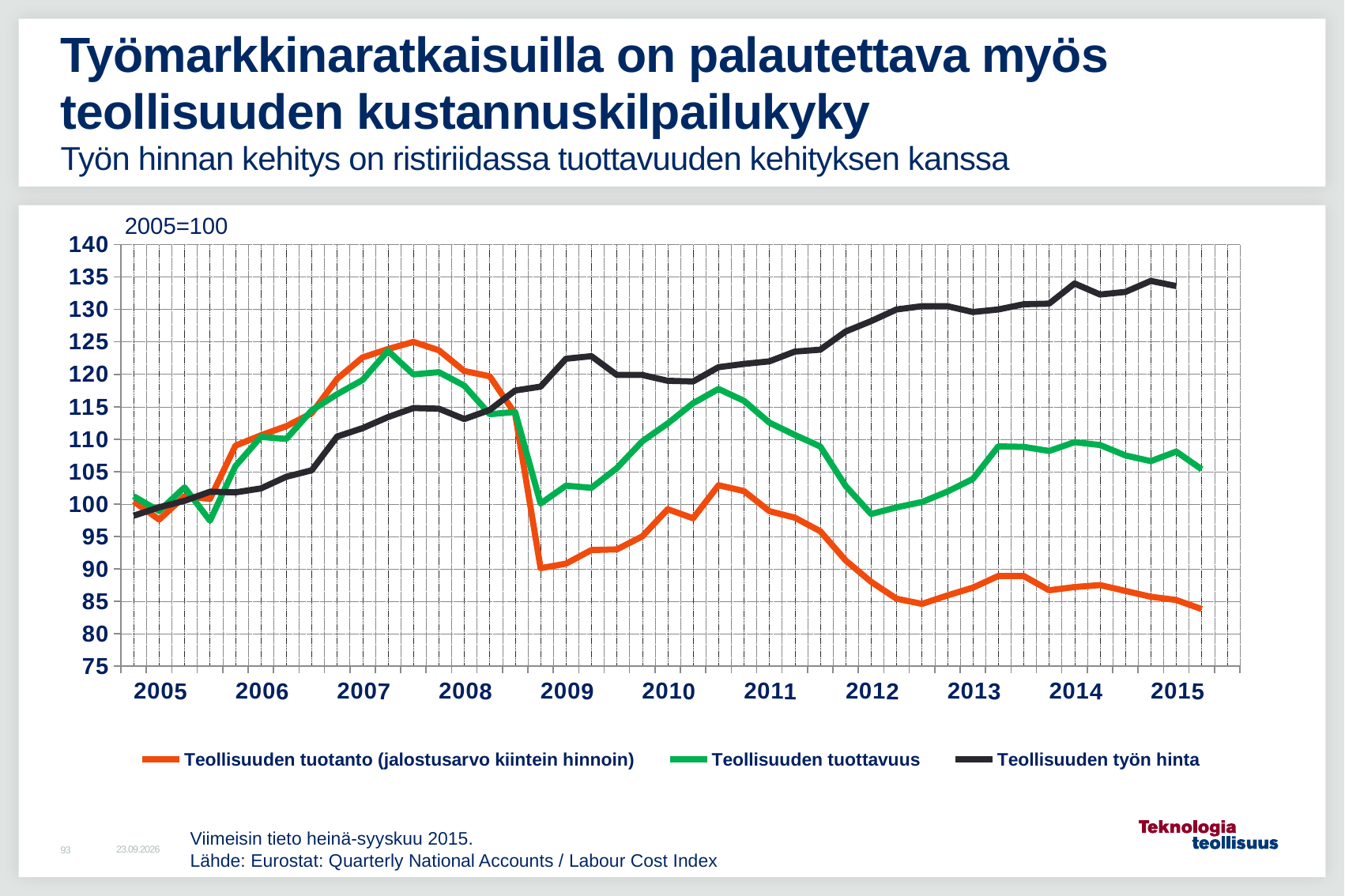
In 2015, which is larger: Teollisuuden tuottavuus or Teollisuuden tuotanto (jalostusarvo kiintein hinnoin)? Teollisuuden tuottavuus How many series does the legend list? 3 What kind of chart is shown on the slide? line chart Is the value for Teollisuuden tuotanto (jalostusarvo kiintein hinnoin) in 2015 greater or less than 90? less Is the value for Teollisuuden tuottavuus in 2015 greater or less than 100? greater Does the Teollisuuden työn hinta line rise or fall overall from 2005 to 2015? rise Which series has the lowest value at the end of the chart in 2015? Teollisuuden tuotanto (jalostusarvo kiintein hinnoin) Which series is plotted with the black line? Teollisuuden työn hinta How many year labels are shown on the x axis? 11 Which series has the highest value at the end of the chart in 2015? Teollisuuden työn hinta What base-year note is printed above the chart? 2005=100 Is the value for Teollisuuden työn hinta in 2015 greater or less than 130? greater